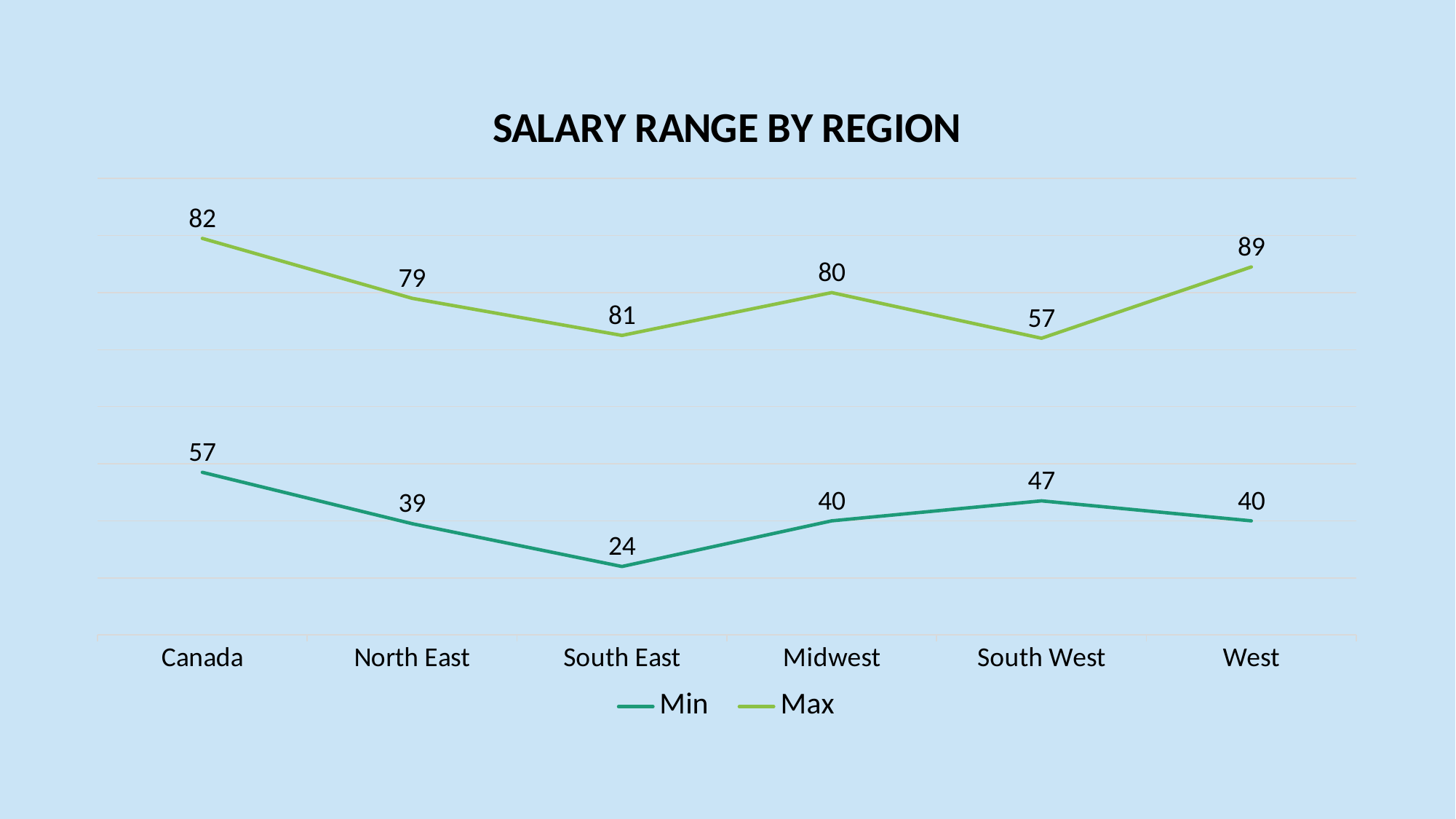
Which region has the highest Max value? West Which is larger, the Min value for South West or the Min value for North East? South West How many regions are shown on the x axis? 6 Which region has the lowest Max value? South West What is the difference between the Max and Min values for Canada? 25 What is the Max value for West? 89 What is the Max value for South West? 57 What is the Min value for South East? 24 How many series does the legend list? 2 What kind of chart is shown on the slide? Line chart What is the Min value for Canada? 57 Which region has the lowest Min value? South East